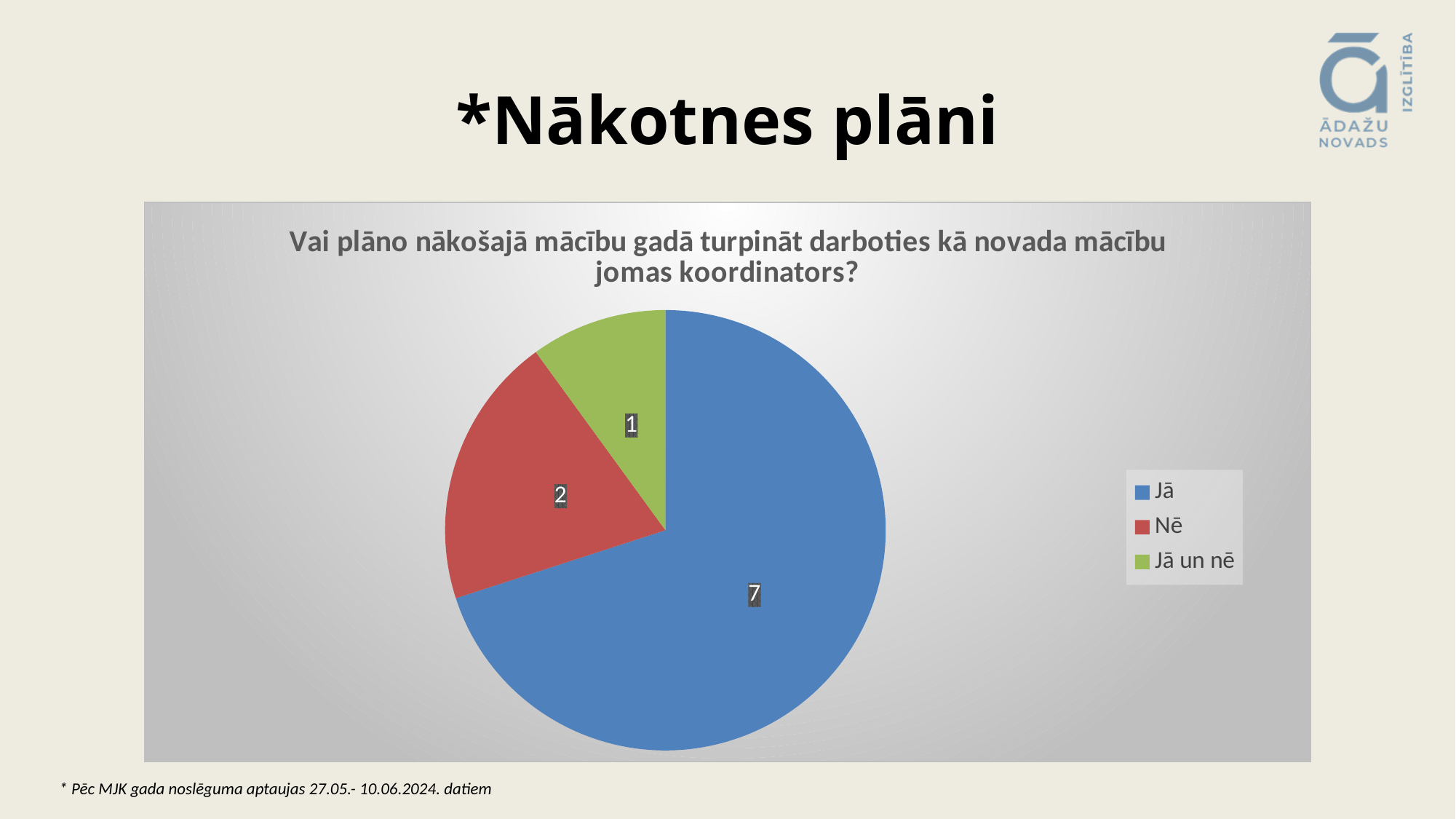
Which category has the largest slice? Jā What is the value for "Jā un nē"? 1 How many slices does the pie chart have? 3 Which category has the smallest slice? Jā un nē What is the value for "Nē"? 2 Which is larger, the value for "Nē" or the value for "Jā un nē"? Nē What colour is the "Nē" slice? red What kind of chart is shown on the slide? pie chart What is the difference between the values for "Jā" and "Nē"? 5 What is the total of all slices in the pie chart? 10 What share of the pie does the "Jā" slice represent? 70% What is the value for "Jā"? 7